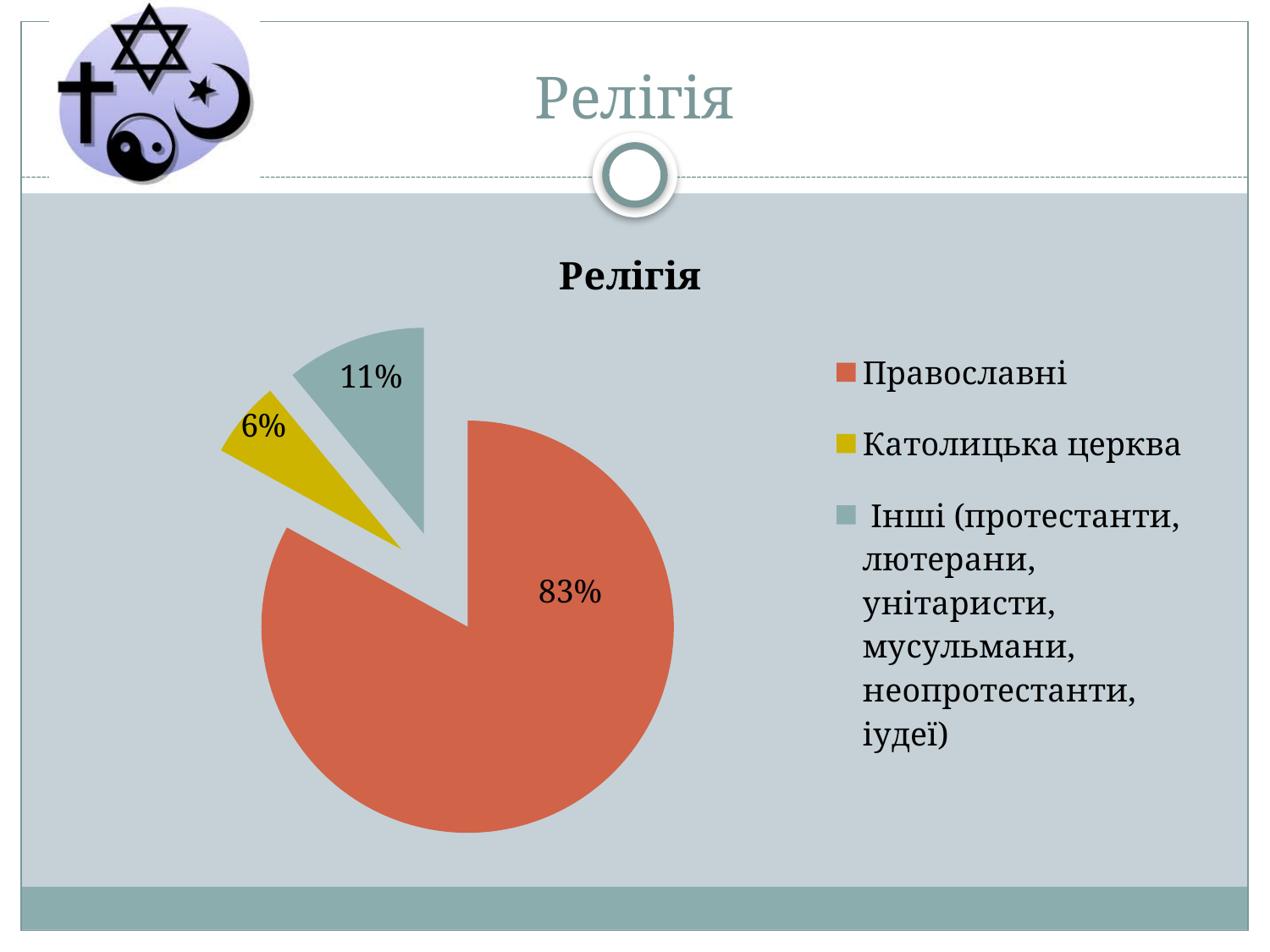
Which category has the smallest slice of the pie? Католицька церква Which category has the largest slice of the pie? Православні What is the value shown for the Інші (протестанти, лютерани, унітаристи, мусульмани, неопротестанти, іудеї) slice? 11% How many slices does the pie chart have? 3 What is the value shown for Католицька церква? 6% Which is larger, the Католицька церква slice or the Інші slice? Інші What share of the pie does Православні hold? 83% What colour is the Православні slice? Red What is the difference between the Православні share and the Інші share? 72% What is the title of the chart? Релігія What is the difference between the Інші share and the Католицька церква share? 5% What kind of chart is shown on the slide? Pie chart